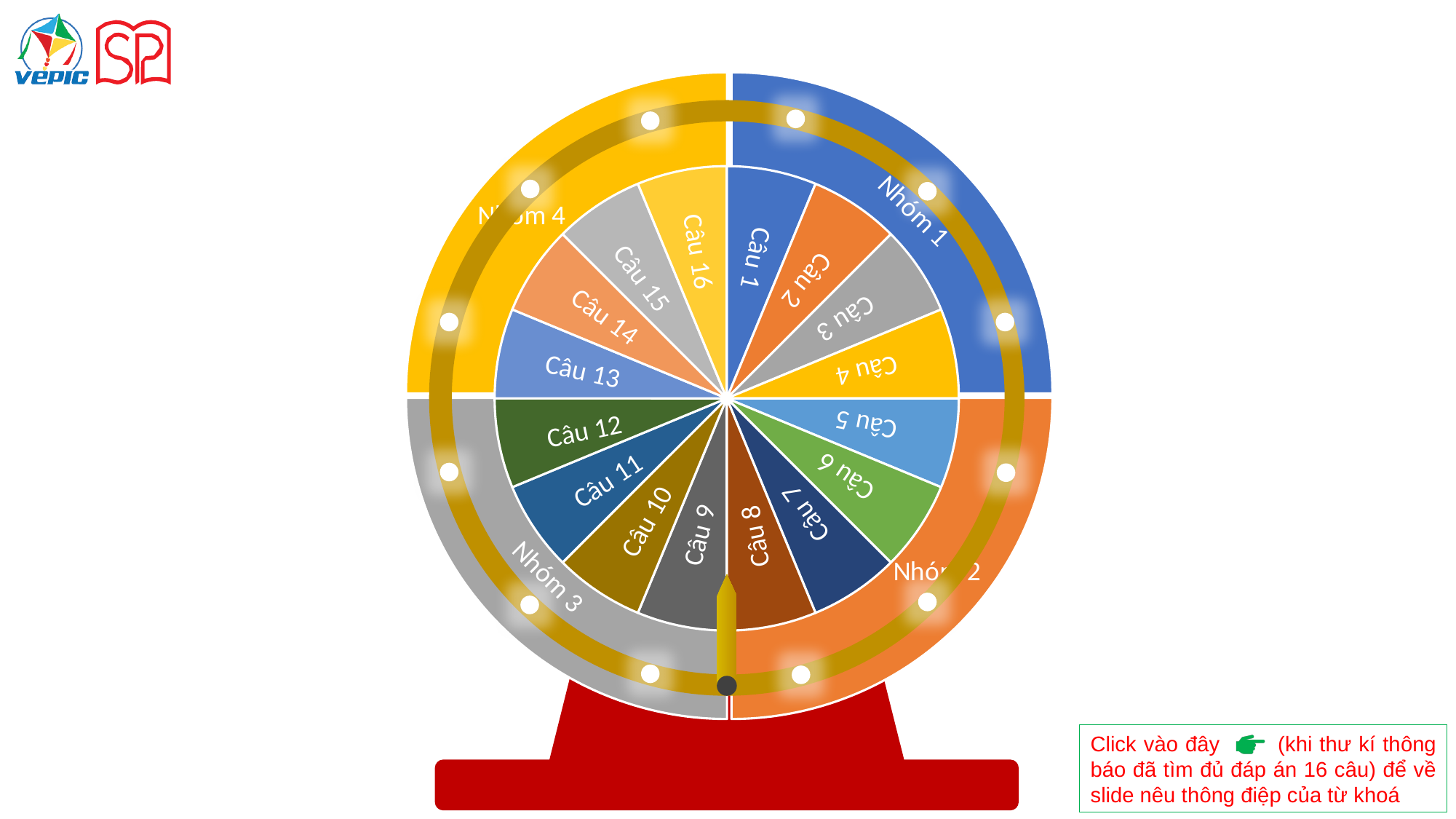
How many numbered slices (Câu) does the wheel contain? 16 What kind of chart is the wheel in the centre of the slide based on? pie chart What is the label of the slice directly to the left of Câu 1 at the top of the wheel? Câu 16 What is the label of the slice immediately clockwise from Câu 4? Câu 5 How many groups (Nhóm) are labelled on the outer ring of the wheel? 4 Which group label appears on the outer ring in the upper-right quadrant of the wheel? Nhóm 1